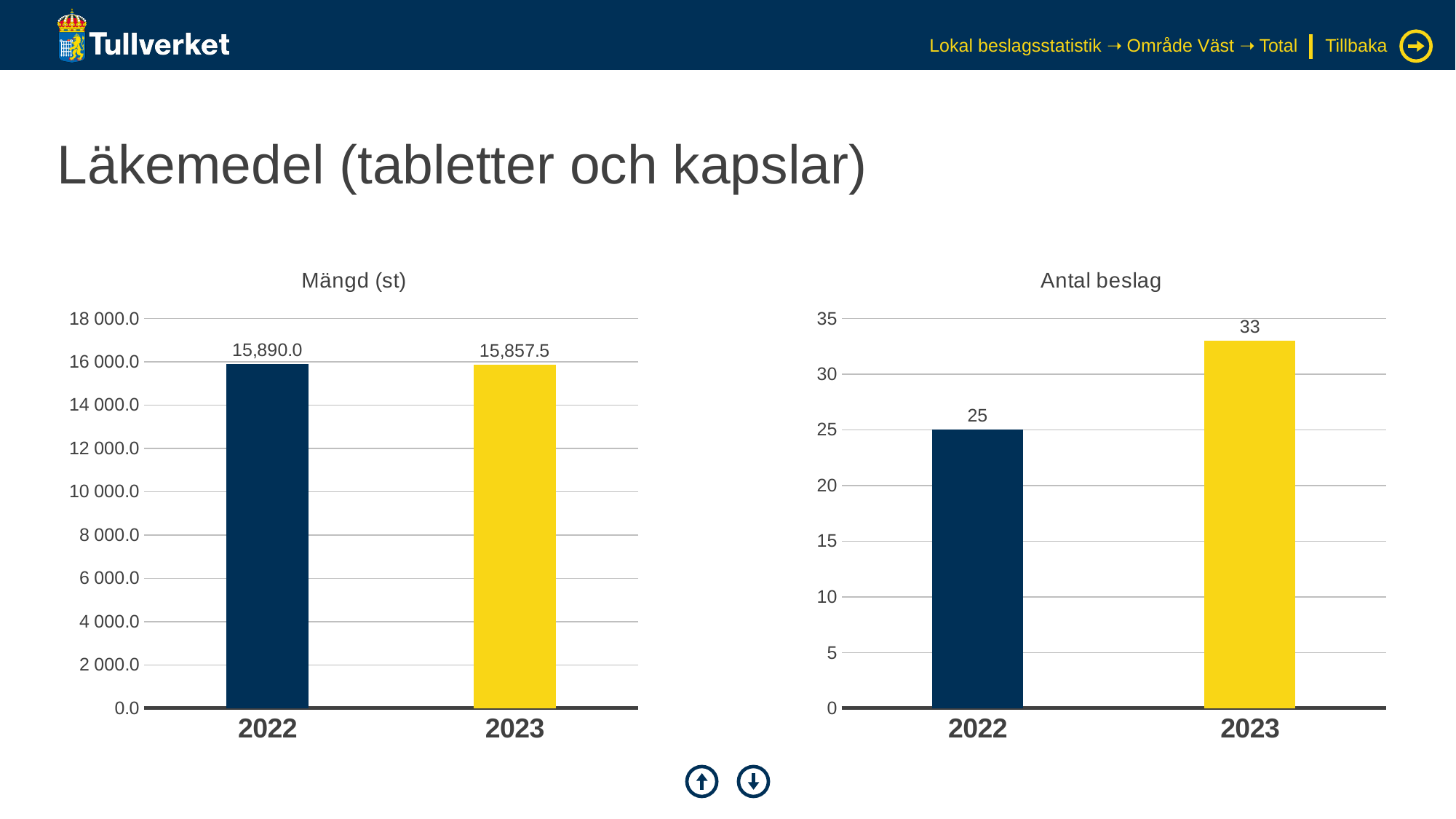
In the 'Mängd (st)' chart, what is the difference between the 2022 and 2023 values? 32.5 What kind of chart is the 'Antal beslag' chart? bar chart In the 'Mängd (st)' chart, what is the value for 2022? 15,890.0 In the 'Antal beslag' chart, which year has the highest value? 2023 In the 'Antal beslag' chart, what is the value for 2023? 33 In the 'Mängd (st)' chart, what is the value for 2023? 15,857.5 In the 'Antal beslag' chart, do the values rise or fall from 2022 to 2023? rise How many categories are shown on the x axis of the 'Mängd (st)' chart? 2 In the 'Antal beslag' chart, what is the value for 2022? 25 In the 'Antal beslag' chart, is the value for 2022 greater or less than 30? less In the 'Mängd (st)' chart, which year has the lowest value? 2023 In the 'Antal beslag' chart, what is the difference between the 2023 and 2022 values? 8